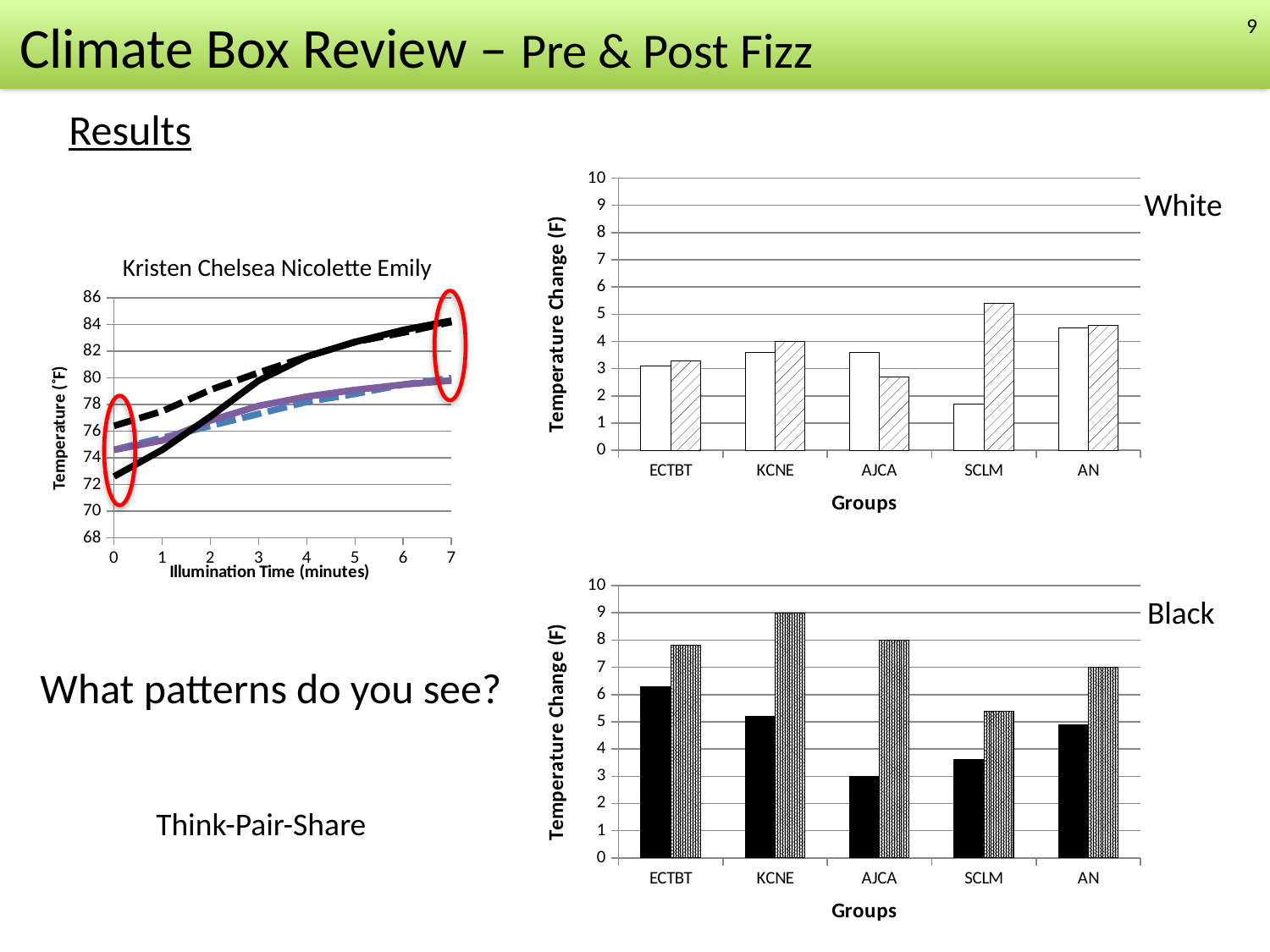
What kind of chart is the chart labeled "White" on the right of the slide? bar chart In the chart labeled "White", is the solid bar for SCLM greater or less than 2? less In the chart labeled "Black", which group has the shortest solid black bar? AJCA In the line chart titled "Kristen Chelsea Nicolette Emily", do the lines rise or fall as illumination time increases? rise In the chart labeled "White", is the hatched bar for SCLM greater or less than 5? greater In the chart labeled "White", which group has the tallest bar? SCLM In the chart labeled "Black", which group has the tallest patterned bar? KCNE What is the x-axis title of the line chart titled "Kristen Chelsea Nicolette Emily"? Illumination Time (minutes) In the chart labeled "Black", which solid black bar is taller, ECTBT or KCNE? ECTBT How many groups are shown on the x axis of the chart labeled "Black"? 5 What is the y-axis title of the chart labeled "Black"? Temperature Change (F) In the chart labeled "Black", is the solid black bar for ECTBT greater or less than 5? greater